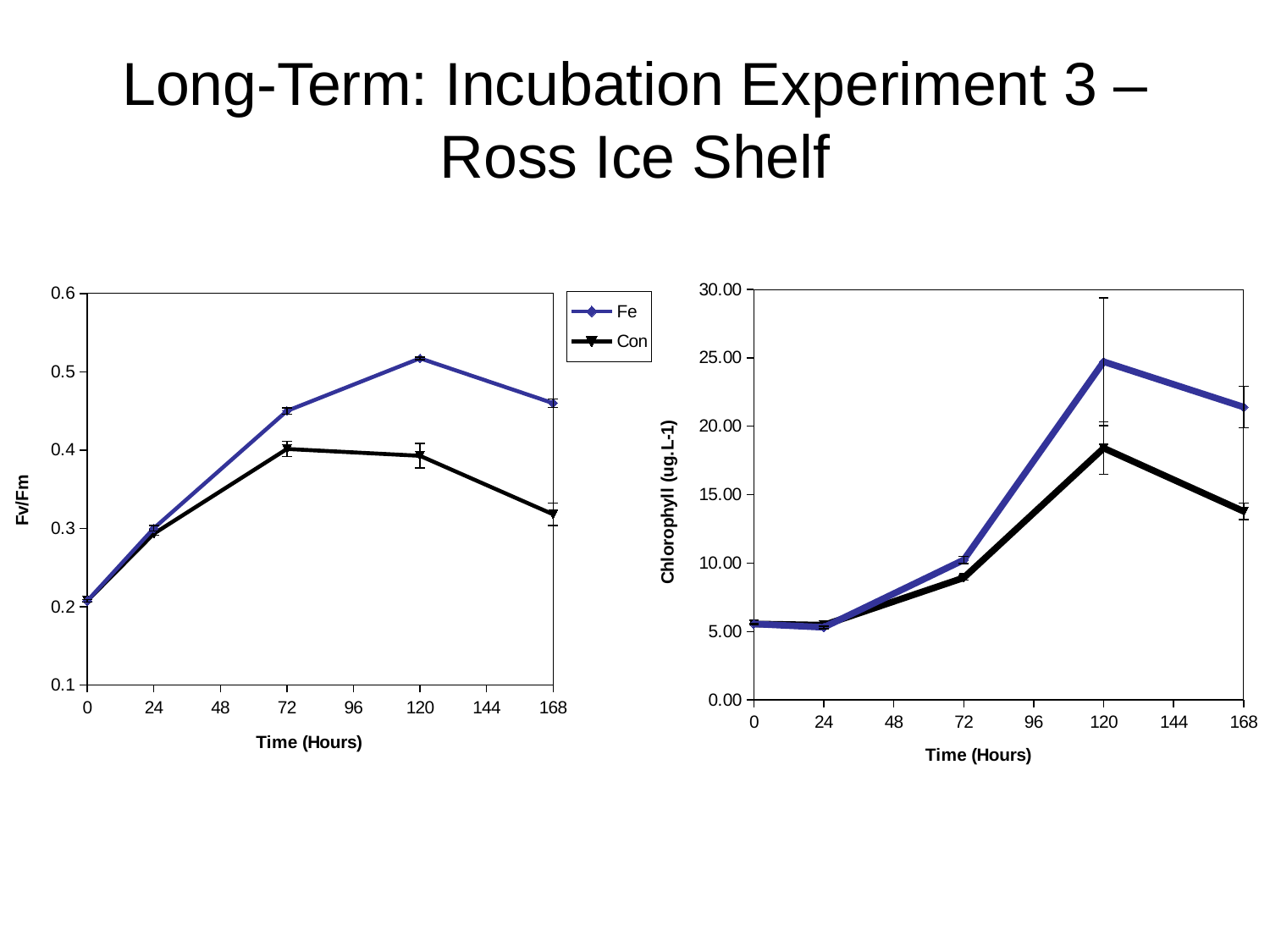
On the left chart, is the Fe value at 120 hours greater or less than 0.5? greater What is the y-axis label of the right chart? Chlorophyll (ug.L-1) What are the two series named in the legend of the left chart? Fe and Con On the right chart (Chlorophyll), at which time (hours) does the blue series reach its peak? 120 On the left chart, at 120 hours, which series has the higher Fv/Fm value, Fe or Con? Fe On the right chart (Chlorophyll), is the black series value at 168 hours greater or less than 15.00? less How many series does the legend on the left chart list? 2 On the left chart, at which time (hours) does the Fe series reach its highest Fv/Fm value? 120 What kind of chart is the left chart (Fv/Fm)? line chart On the left chart, how many time points are plotted for the Fe series? 5 On the left chart, is the Con value at 168 hours greater or less than 0.4? less